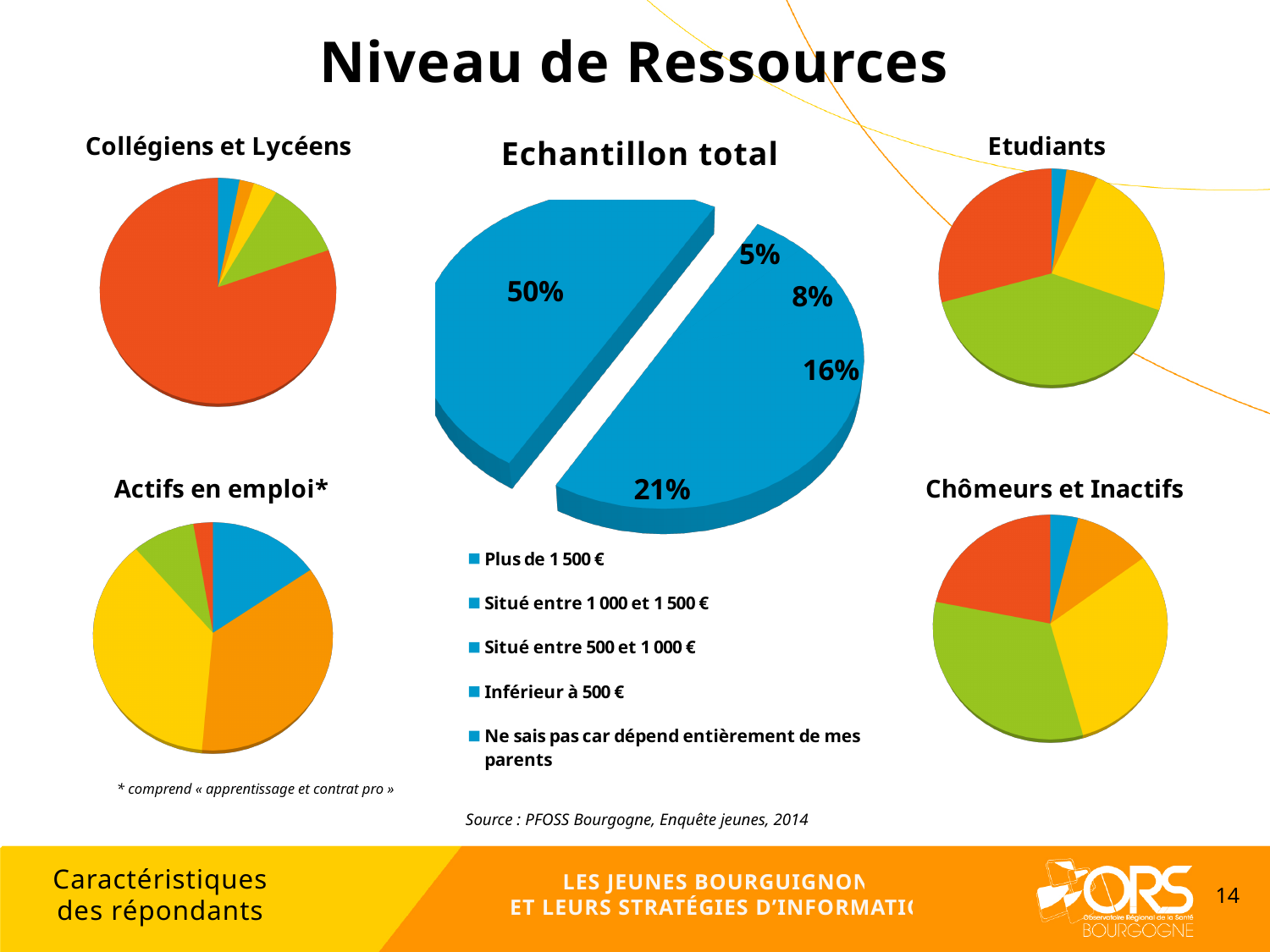
What kind of chart is the 'Chômeurs et Inactifs' chart? pie chart In the 'Echantillon total' chart, which is larger: the slice labelled 21% or the slice labelled 16%? 21% In the 'Echantillon total' chart, what is the value of the largest slice? 50% In the 'Echantillon total' chart, what is the difference between the 16% slice and the 8% slice? 8 percentage points How many pie charts are shown on the slide? 5 In the 'Echantillon total' chart, what is the value of the smallest slice? 5% In the 'Echantillon total' chart, what do the five slice labels add up to? 100% How many entries does the legend of the 'Echantillon total' chart list? 5 In the 'Echantillon total' chart, what is the difference between the 50% slice and the 21% slice? 29 percentage points What kind of chart is the 'Echantillon total' chart? pie chart What is the title of the large central chart on the slide? Echantillon total How many slices does the 'Echantillon total' pie chart have? 5